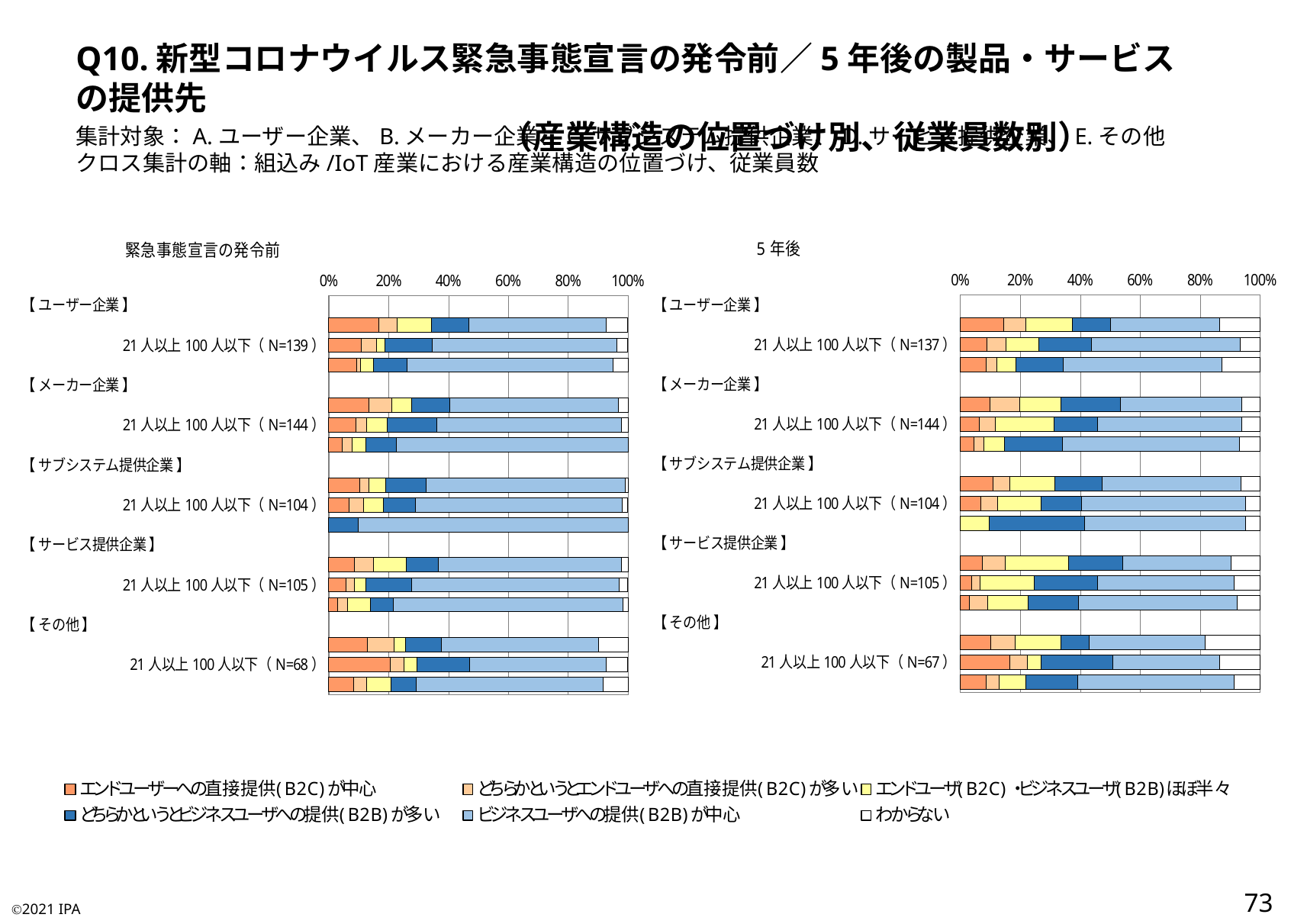
What is the title of the chart on the right side of the slide? 5年後 What is the title of the chart on the left side of the slide? 緊急事態宣言の発令前 How many series does the legend list? 6 What kind of chart is used on this slide for the 緊急事態宣言の発令前 and 5年後 data? Stacked bar chart In the 緊急事態宣言の発令前 chart, is the エンドユーザーへの直接提供(B2C)が中心 segment for サブシステム提供企業 21人以上100人以下 (N=104) greater or less than 20%? less In the 5年後 chart, is the エンドユーザーへの直接提供(B2C)が中心 segment for ユーザー企業 21人以上100人以下 (N=137) greater or less than 20%? less In the 緊急事態宣言の発令前 chart, which has the larger エンドユーザーへの直接提供(B2C)が中心 segment: その他 21人以上100人以下 (N=68) or ユーザー企業 21人以上100人以下 (N=139)? その他 21人以上100人以下 (N=68) In the 緊急事態宣言の発令前 chart, is the ビジネスユーザへの提供(B2B)が中心 segment for メーカー企業 21人以上100人以下 (N=144) greater or less than 40%? greater In the 緊急事態宣言の発令前 chart, how many industry-position groups (bracketed headings) are shown? 5 For ユーザー企業 21人以上100人以下, is the ビジネスユーザへの提供(B2B)が中心 segment larger in the 緊急事態宣言の発令前 chart (N=139) or in the 5年後 chart (N=137)? 緊急事態宣言の発令前 In the 5年後 chart, how many bars are plotted in total? 15